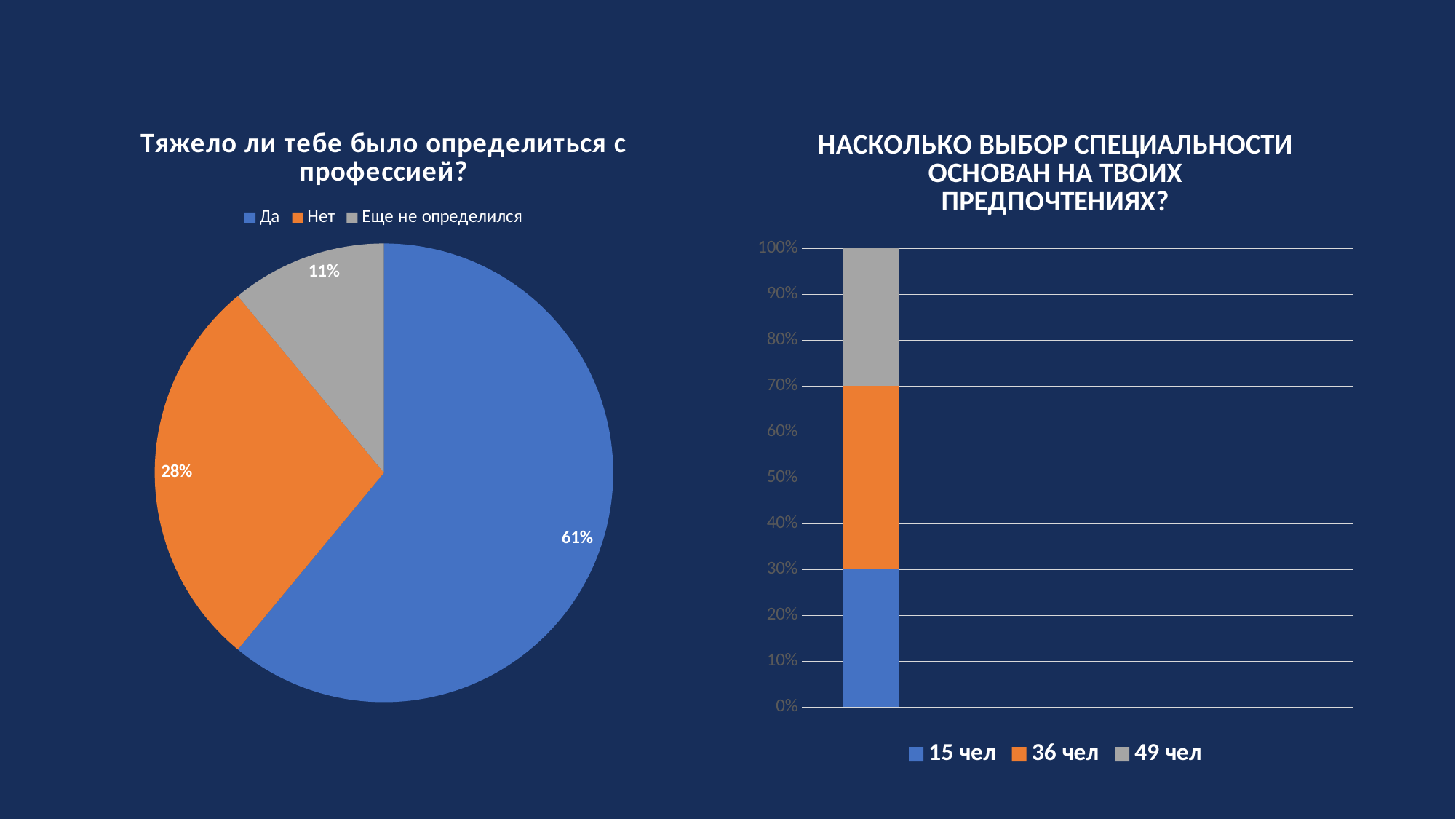
In the pie chart on the left, which is larger: the share for "Нет" or the share for "Еще не определился"? Нет How many slices does the pie chart on the left have? 3 In the pie chart on the left, what share is labelled "Еще не определился"? 11% What type of chart is shown on the right side of the slide? Stacked bar chart How many series does the legend of the chart on the right list? 3 In the pie chart on the left, which answer has the largest share? Да In the pie chart on the left, what is the difference in percentage points between "Да" and "Нет"? 33 What is the title of the pie chart on the left? Тяжело ли тебе было определиться с профессией? In the pie chart on the left, what share of respondents answered "Да"? 61% In the pie chart on the left, what share of respondents answered "Нет"? 28% In the pie chart on the left, which answer has the smallest share? Еще не определился In the chart on the right, is the top of the blue "15 чел" segment greater or less than 50%? less